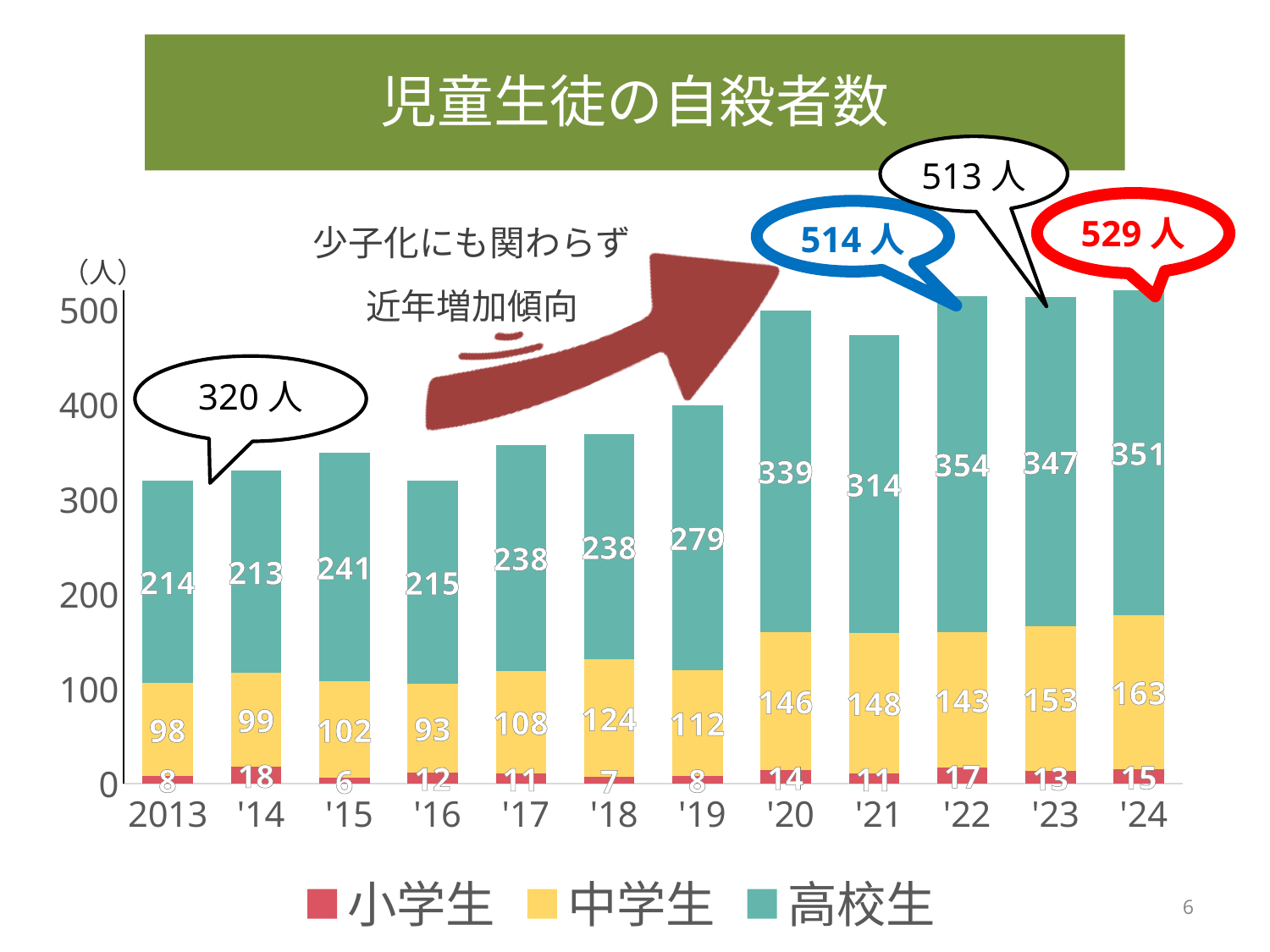
What is the difference between the 高校生 values for '19 and '18? 41 What is the total of the stacked bar for '24? 529 How many series does the legend list? 3 Which is larger, the 中学生 value for '24 or for '23? '24 What is the value for 中学生 in '18? 124 What kind of chart is shown? Stacked bar chart What is the title of the chart? 児童生徒の自殺者数 How many years are shown on the x axis? 12 In which year is the 高校生 value highest? '22 In which year is the 中学生 value lowest? '16 What is the value for 高校生 in '20? 339 What is the value for 小学生 in '14? 18